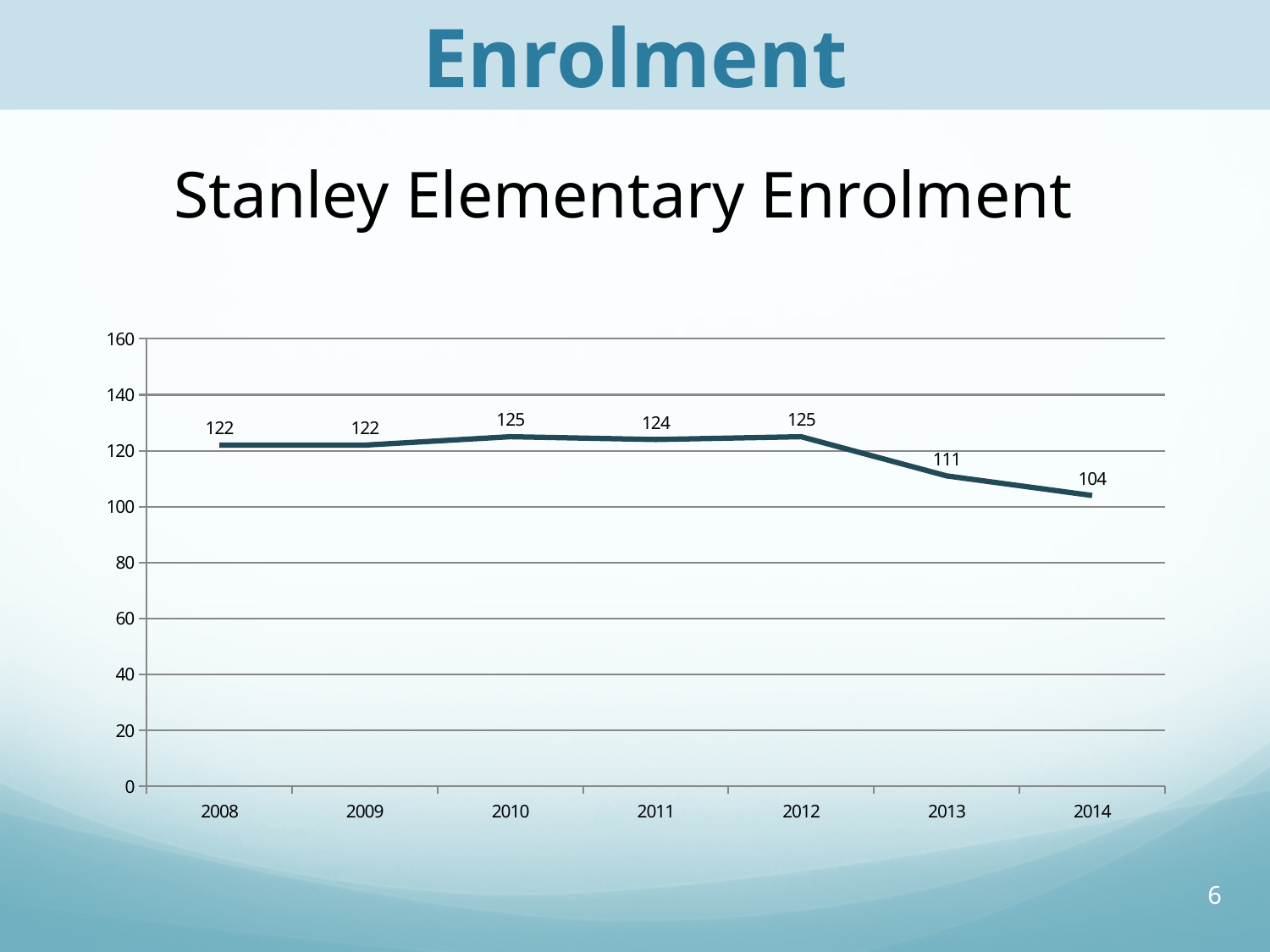
What is the title of the chart? Stanley Elementary Enrolment What was the enrolment in 2014? 104 What was the enrolment in 2011? 124 Does enrolment rise or fall from 2012 to 2014? fall Is the enrolment for 2013 greater or less than 120? less What is the difference in enrolment between 2012 and 2013? 14 Which year had higher enrolment, 2010 or 2013? 2010 What kind of chart is shown on the slide? line chart What was the enrolment in 2008? 122 What is the difference in enrolment between 2008 and 2014? 18 Which year had the lowest enrolment? 2014 How many years are shown on the x axis? 7